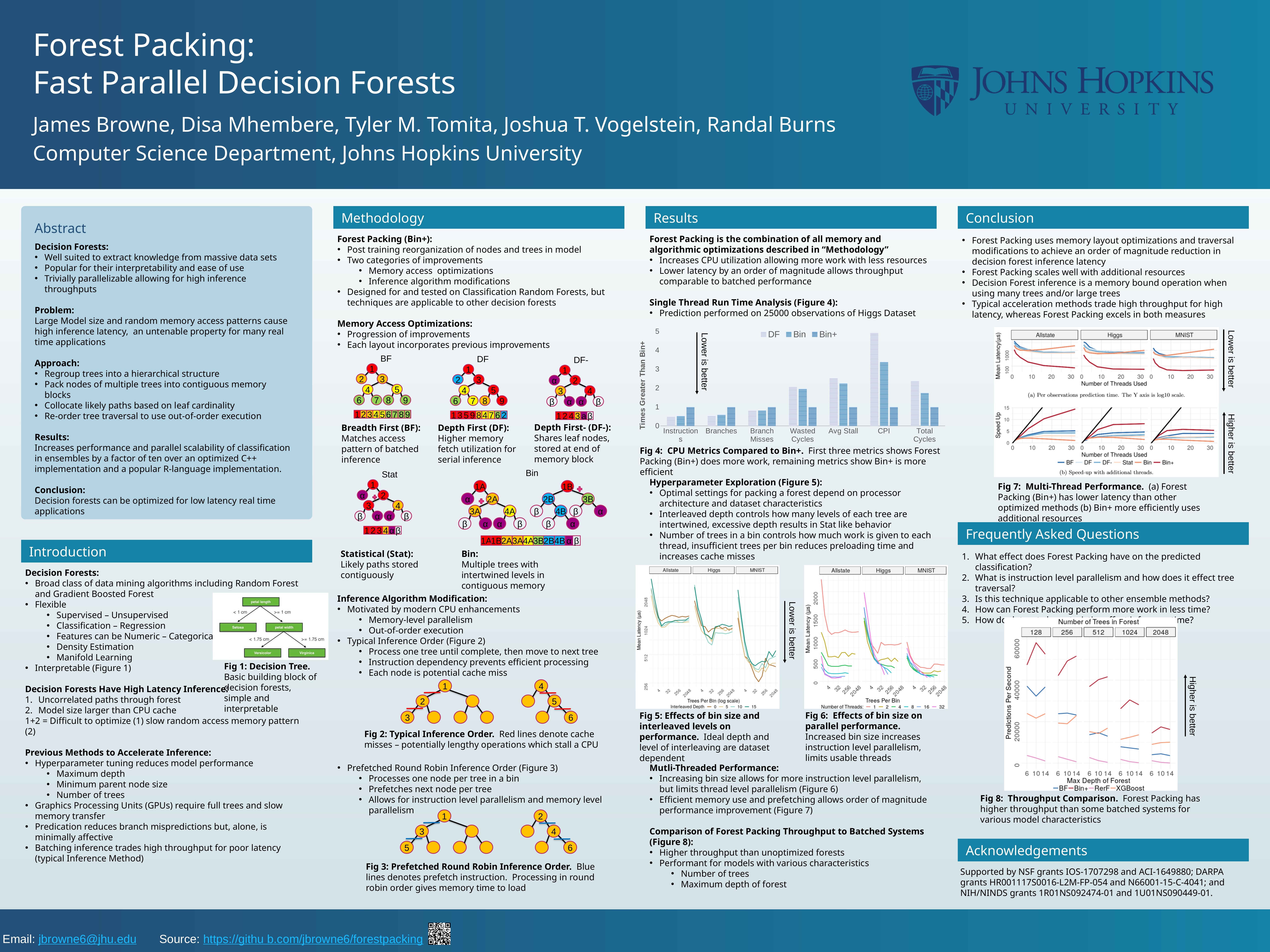
How many series does the legend of Fig 4 list? 3 In Fig 4, for Total Cycles, which is larger: the DF value or the Bin value? DF How many categories are shown on the x axis of Fig 4? 7 What are the legend entries in Fig 4? DF, Bin, Bin+ What is the y-axis title of Fig 4? Times Greater Than Bin+ What kind of chart is Fig 4 (CPU Metrics Compared to Bin+)? bar chart In Fig 4, which category has the highest DF value? CPI In Fig 4, is the DF value for Instructions greater or less than 1? less In Fig 4, is the DF value for CPI greater or less than 4? greater In Fig 4, is the Bin value for Wasted Cycles greater or less than 1? greater In Fig 4, for CPI, which is larger: the DF value or the Bin value? DF